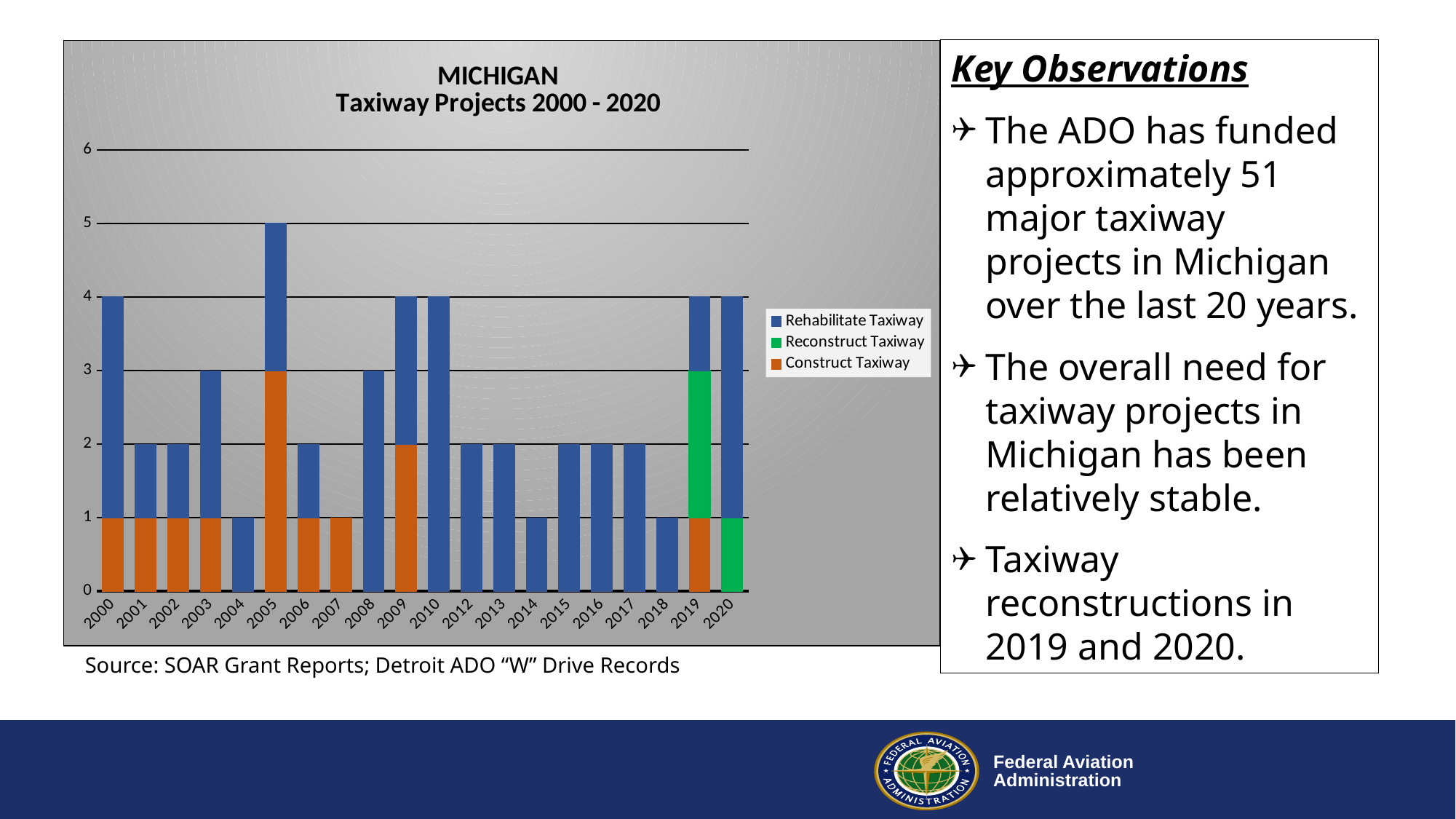
What is the Construct Taxiway value for 2005? 3 What is the title of the chart? MICHIGAN Taxiway Projects 2000 - 2020 How many years are shown along the x axis of the chart? 20 Which year has the tallest stacked bar in the chart? 2005 What is the total height of the stacked bar for 2005? 5 What are the three legend entries in the chart? Rehabilitate Taxiway, Reconstruct Taxiway, Construct Taxiway Which year has the taller bar, 2010 or 2014? 2010 How many series does the chart's legend list? 3 What is the difference between the total bar heights for 2005 and 2004? 4 What kind of chart is shown on the slide? Stacked bar chart Is the total value for 2005 greater or less than 4? greater What is the Reconstruct Taxiway value for 2019? 2